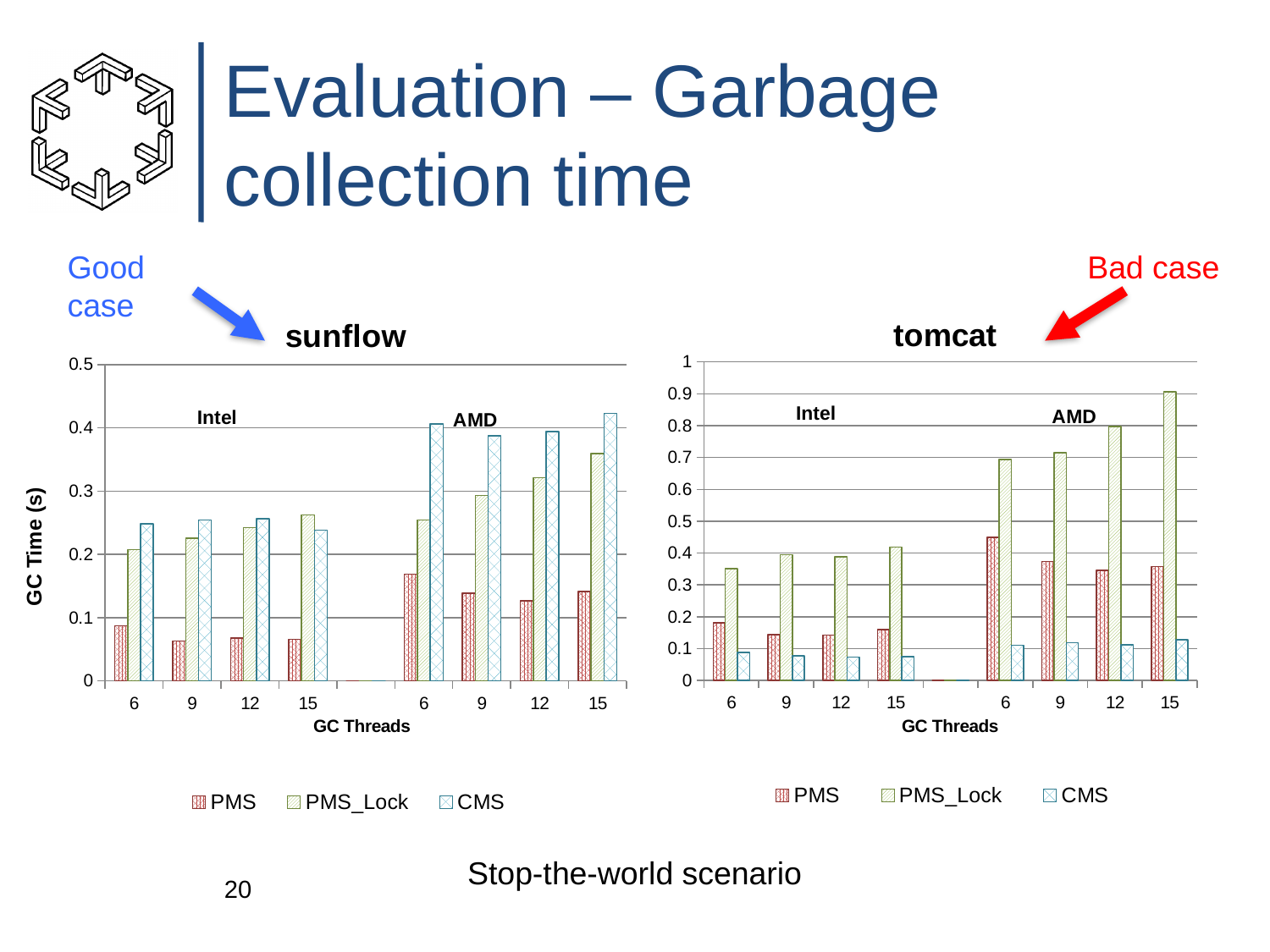
What is the y-axis label of the sunflow chart? GC Time (s) In the tomcat chart, is the PMS_Lock value at 15 GC threads on AMD greater or less than 0.8? greater What kind of chart is the sunflow chart? bar chart In the sunflow chart, at 6 GC threads on Intel, which is larger: PMS or CMS? CMS How many GC thread settings are shown for each platform in the sunflow chart? 4 In the sunflow chart, is the PMS value at 6 GC threads on Intel greater or less than 0.1? less In the tomcat chart, which series has the tallest bar overall? PMS_Lock In the sunflow chart, is the CMS value at 15 GC threads on AMD greater or less than 0.4? greater How many series does the legend of the tomcat chart list? 3 In the tomcat chart, do the PMS_Lock values on AMD rise or fall as GC threads increase from 6 to 15? rise In the tomcat chart, at 6 GC threads on AMD, which is larger: PMS_Lock or CMS? PMS_Lock